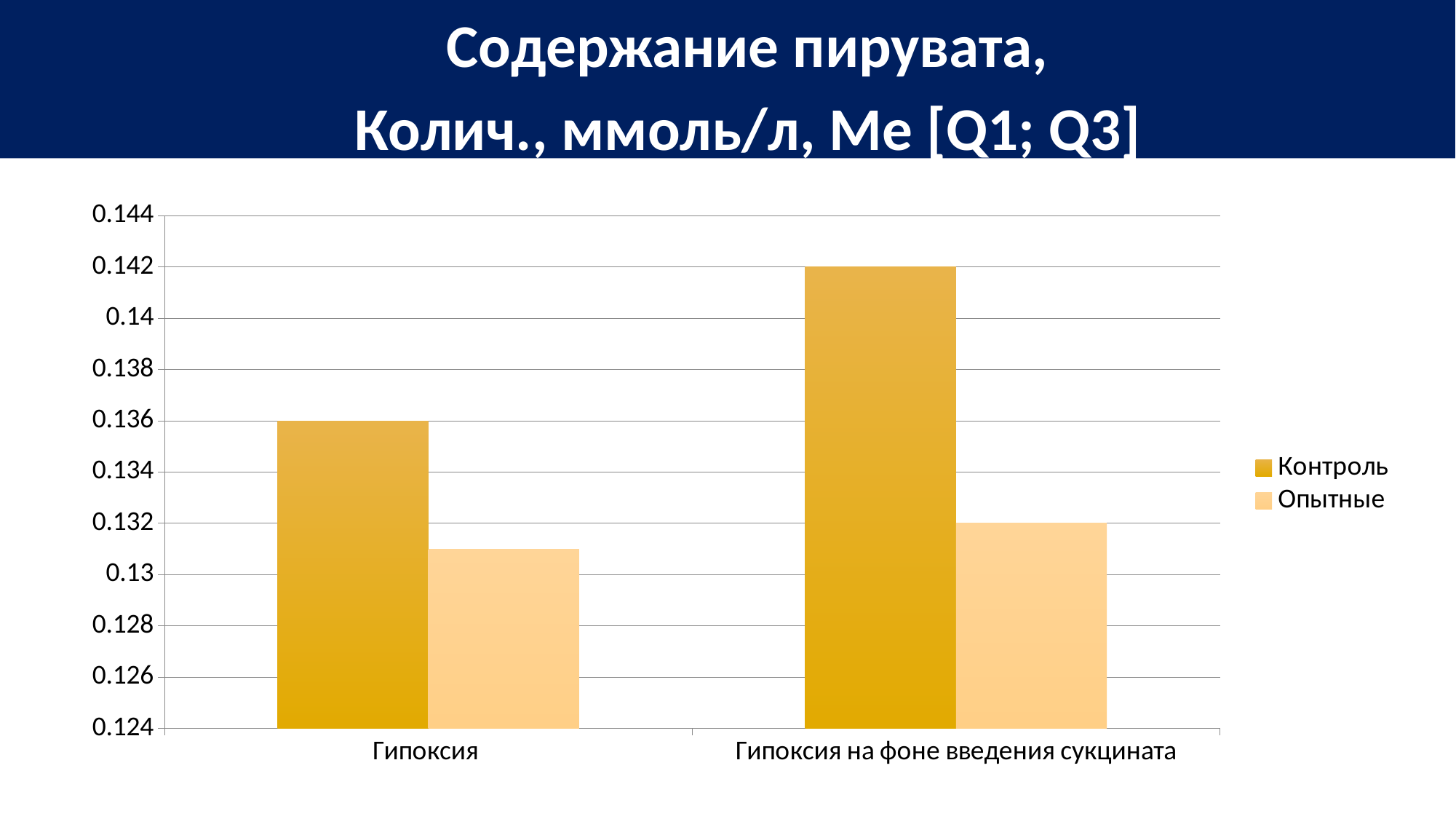
Which bar is the highest on the chart? Контроль, Гипоксия на фоне введения сукцината What is the value for Опытные in the Гипоксия на фоне введения сукцината category? 0.132 What is the value for Контроль in the Гипоксия category? 0.136 Which bar is the lowest on the chart? Опытные, Гипоксия How many series does the legend list? 2 In the Гипоксия на фоне введения сукцината category, which series has the larger value, Контроль or Опытные? Контроль What are the two series names listed in the legend? Контроль, Опытные How many categories are shown on the x axis? 2 What kind of chart is shown on the slide? bar chart What is the difference between the Контроль values for Гипоксия на фоне введения сукцината and Гипоксия? 0.006 What is the value for Контроль in the Гипоксия на фоне введения сукцината category? 0.142 Is the value for Опытные in the Гипоксия category greater or less than 0.132? less